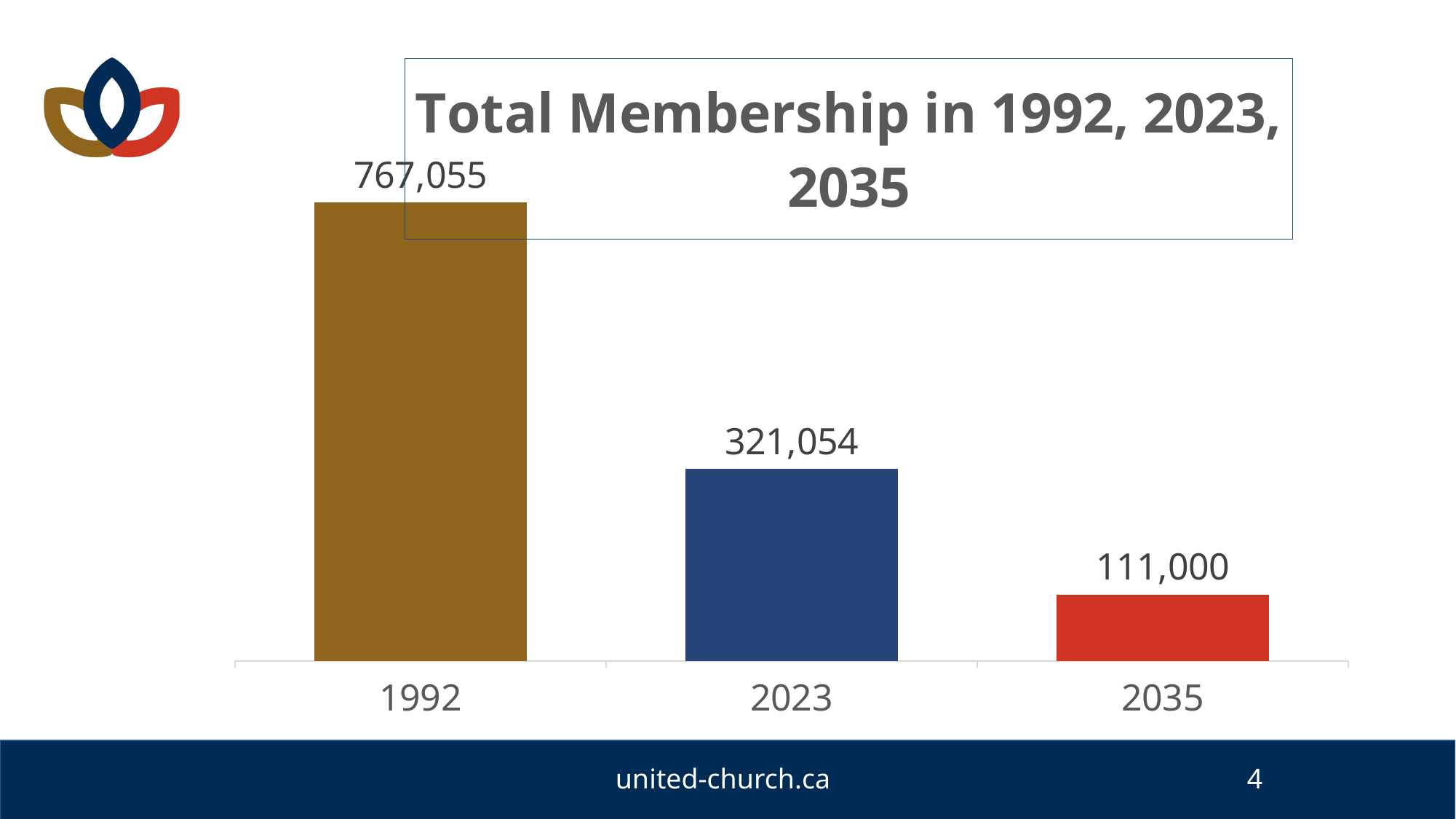
Which year has the highest total membership? 1992 What is the total membership shown for 2023? 321,054 What is the total membership shown for 2035? 111,000 Do the membership values rise or fall from 1992 to 2035? Fall Which is larger, the membership in 2023 or in 2035? 2023 What is the difference in membership between 1992 and 2023? 446,001 Which year has the lowest total membership? 2035 What is the difference in membership between 2023 and 2035? 210,054 What is the total membership shown for 1992? 767,055 What kind of chart is shown on the slide? Bar chart How many years are shown on the chart? 3 What is the title of the chart? Total Membership in 1992, 2023, 2035